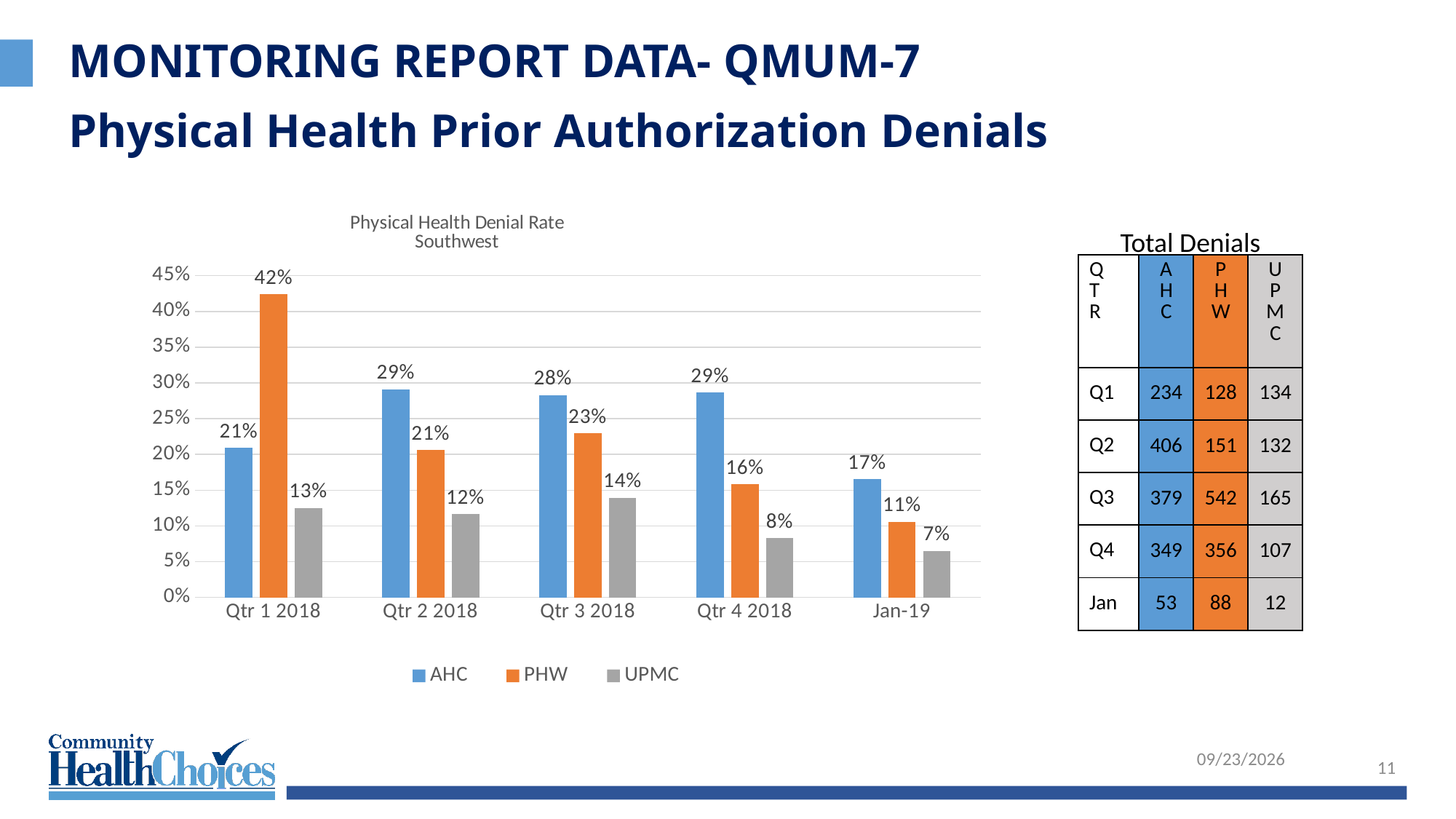
What is the UPMC denial rate for Jan-19? 7% What is the AHC denial rate for Qtr 3 2018? 28% How many periods are shown on the x axis of the chart? 5 What is the title of the chart? Physical Health Denial Rate Southwest How many series does the chart legend list? 3 What is the difference between the PHW and AHC denial rates in Qtr 1 2018? 21% In Qtr 4 2018, which has the higher denial rate, AHC or PHW? AHC What is the PHW denial rate for Qtr 1 2018? 42% What kind of chart is shown on the slide? Bar chart Which period has the lowest UPMC denial rate? Jan-19 Does the PHW denial rate rise or fall from Qtr 3 2018 to Jan-19? Fall Which period has the highest PHW denial rate? Qtr 1 2018